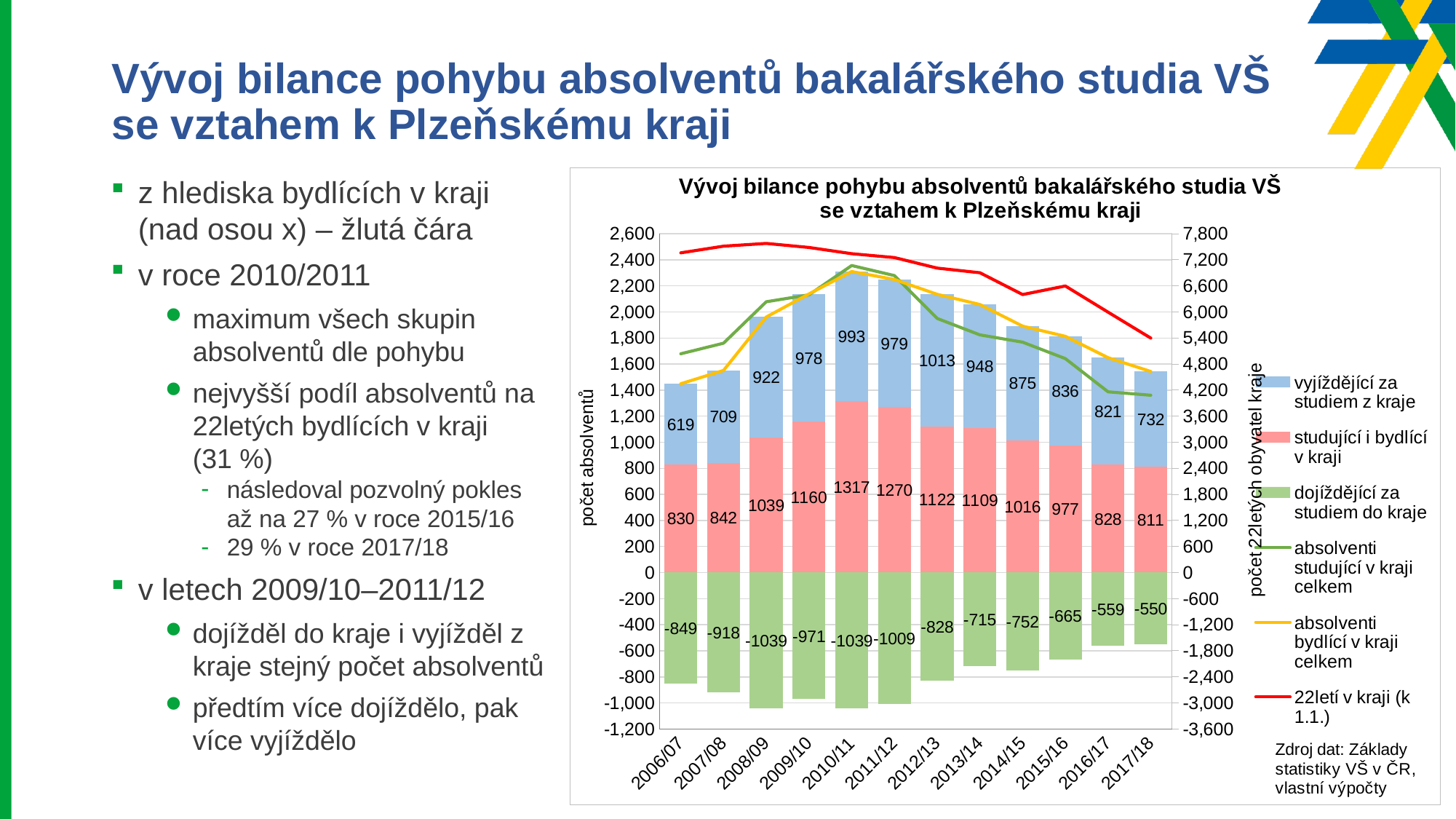
In which year is the value of 'vyjíždějící za studiem z kraje' highest? 2012/13 What type of chart is shown on the slide? Stacked bar chart with line series What is the value of 'dojíždějící za studiem do kraje' in 2015/16? -665 In which year is the value of 'studující i bydlící v kraji' lowest? 2017/18 How many series does the chart legend list? 6 How many academic years are shown on the x axis of the chart? 12 What is the total of the two positive stacked segments ('vyjíždějící za studiem z kraje' and 'studující i bydlící v kraji') in 2010/11? 2310 What is the value of 'vyjíždějící za studiem z kraje' in 2017/18? 732 Is the value of the red line '22letí v kraji (k 1.1.)' in 2017/18 greater or less than 6,000 on the right axis? less What is the value of 'studující i bydlící v kraji' in 2010/11? 1317 Which is larger: 'vyjíždějící za studiem z kraje' in 2008/09 or in 2009/10? 2009/10 What is the difference between 'studující i bydlící v kraji' in 2010/11 and 2011/12? 47